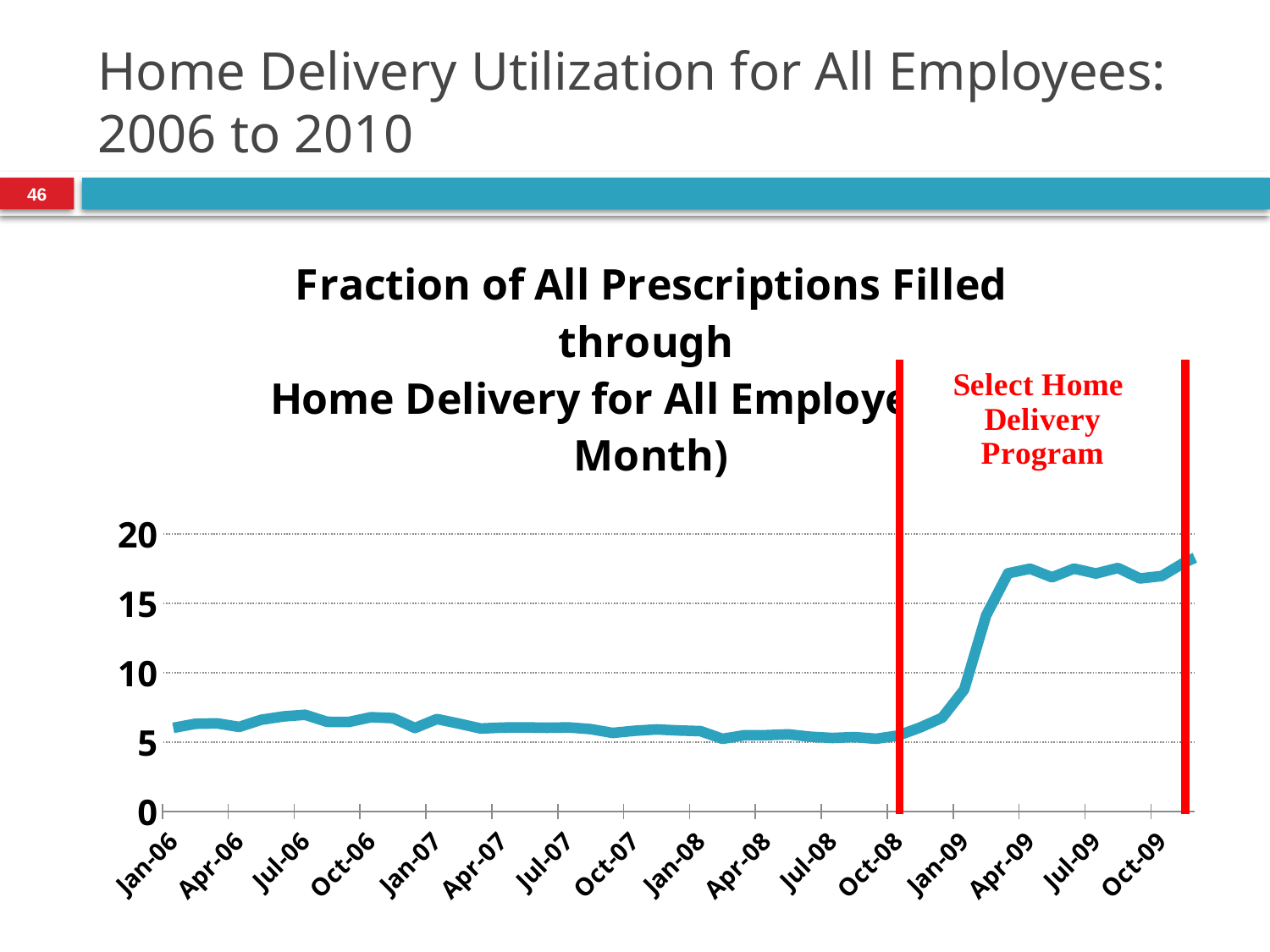
What kind of chart is shown on the slide? line chart Is the value for Oct-08 greater or less than 10? less How many month labels are shown on the x axis? 16 Is the value for Apr-09 greater or less than 15? greater Does the line rise or fall between Oct-08 and Apr-09? rise Is the value for Jan-06 greater or less than 5? greater What label appears in red text between the two vertical red lines? Select Home Delivery Program What is the highest value shown on the y axis? 20 Which has the larger value, Jan-06 or Apr-09? Apr-09